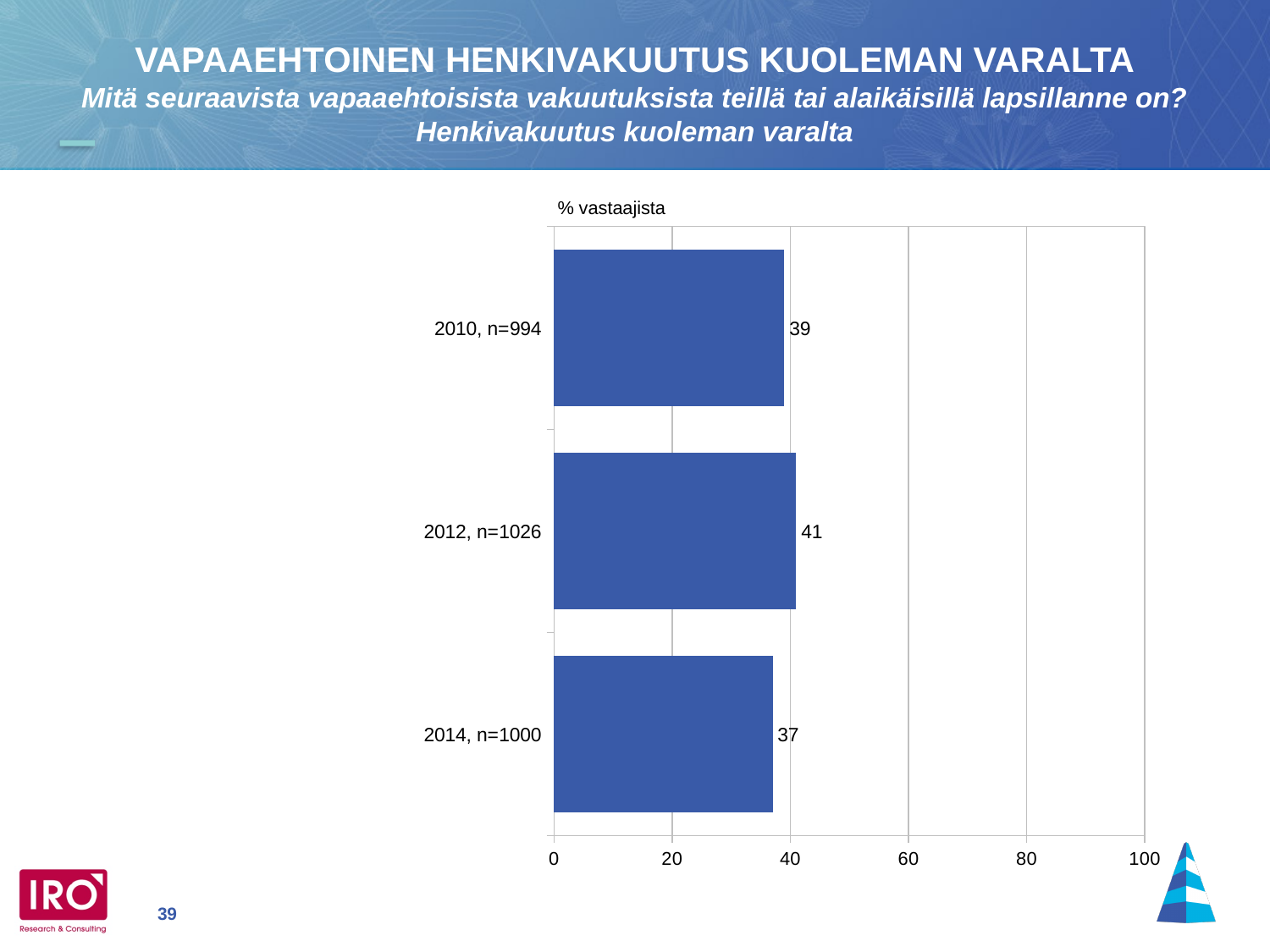
Is the value for 2012, n=1026 greater or less than 40? greater How many categories are shown in the chart? 3 Which category has the highest value? 2012, n=1026 Which is larger, the value for 2010, n=994 or the value for 2014, n=1000? 2010, n=994 What is the value for 2012, n=1026? 41 What is the difference between the values for 2012, n=1026 and 2014, n=1000? 4 What kind of chart is shown on the slide? bar chart What is the label shown above the chart's axis? % vastaajista What is the value for 2010, n=994? 39 What is the difference between the values for 2012, n=1026 and 2010, n=994? 2 What is the value for 2014, n=1000? 37 Which category has the lowest value? 2014, n=1000